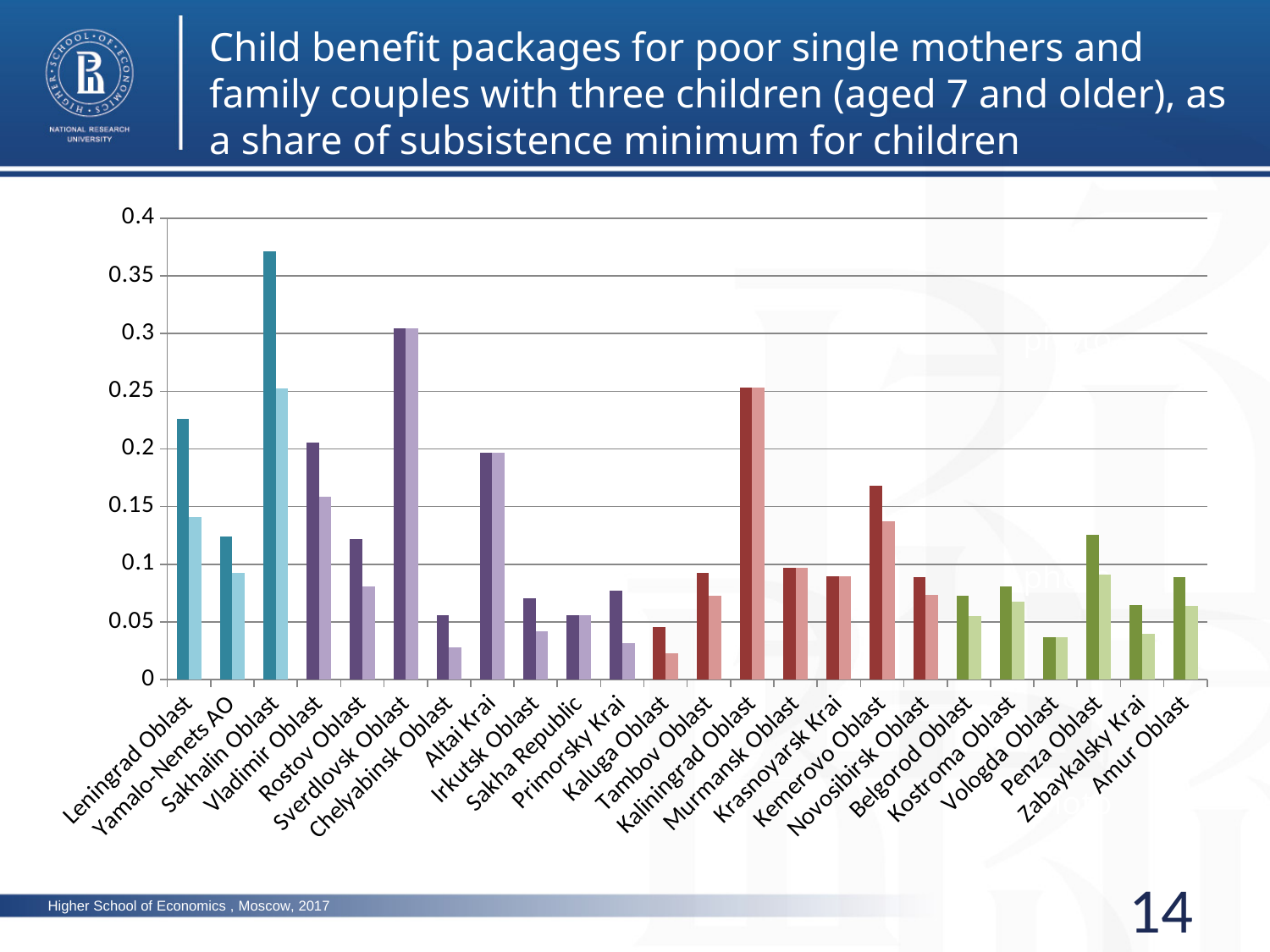
What kind of chart is shown on the slide? bar chart Is the value of the tallest bar for Sakhalin Oblast greater or less than 0.35? greater Which region has the taller first bar: Kaliningrad Oblast or Tambov Oblast? Kaliningrad Oblast Which region has the taller first bar: Sakhalin Oblast or Leningrad Oblast? Sakhalin Oblast Which region has the tallest bar in the chart? Sakhalin Oblast Is the value of the taller bar for Leningrad Oblast greater or less than 0.2? greater What is the highest value shown on the y axis of the chart? 0.4 Is the value of the taller bar for Vologda Oblast greater or less than 0.05? less How many bars are shown for each region in the chart? 2 How many regions are listed along the x axis of the chart? 24